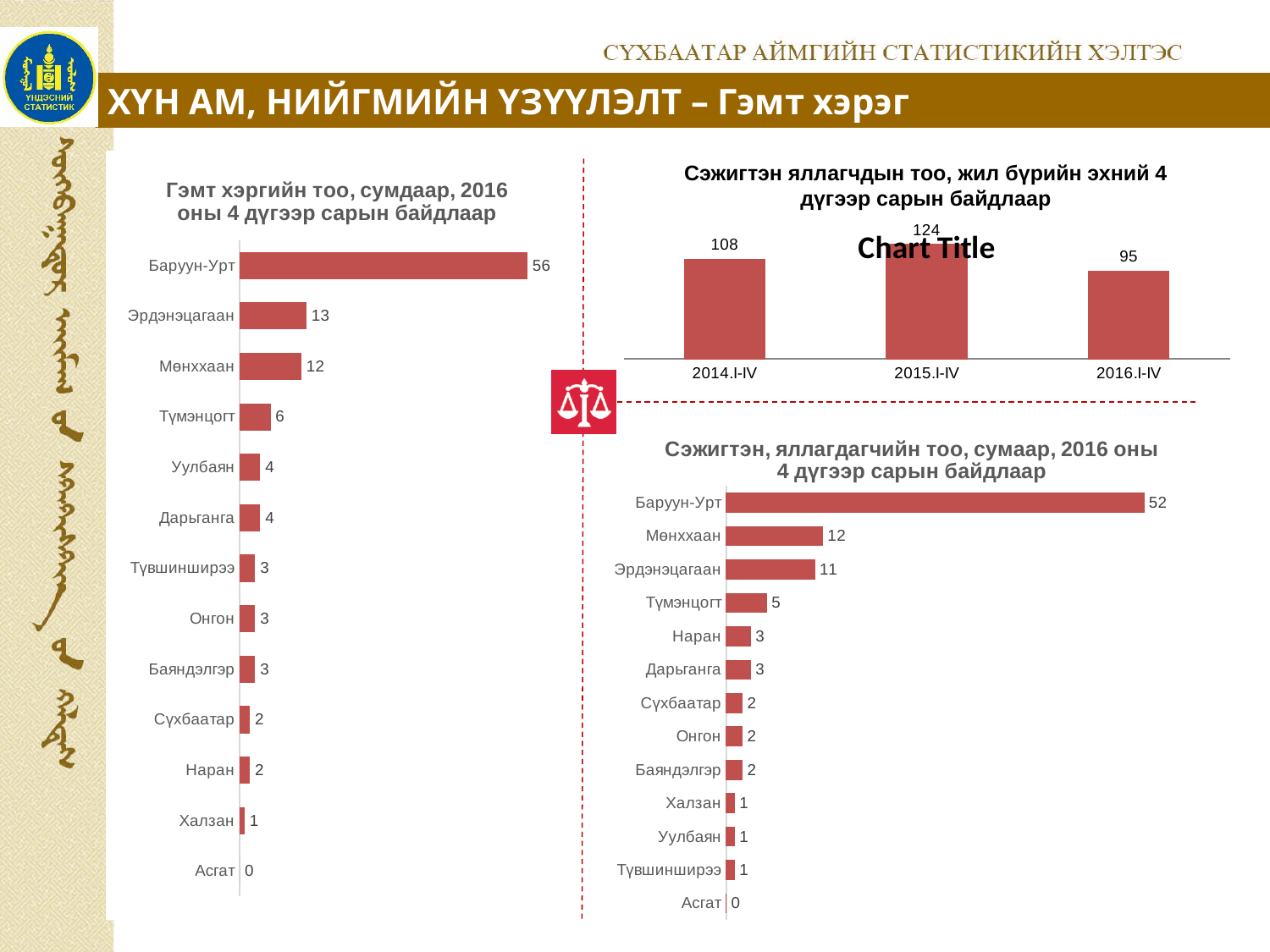
In the left chart (Гэмт хэргийн тоо, сумдаар), how many categories are shown? 13 What kind of chart is the top right chart (Сэжигтэн яллагчдын тоо)? bar chart In the left chart (Гэмт хэргийн тоо, сумдаар), what is the value for Баруун-Урт? 56 In the top right chart (Сэжигтэн яллагчдын тоо), what is the difference between 2015.I-IV and 2016.I-IV? 29 In the top right chart (Сэжигтэн яллагчдын тоо), what is the value for 2015.I-IV? 124 In the left chart (Гэмт хэргийн тоо, сумдаар), which category has the lowest value? Асгат In the bottom right chart (Сэжигтэн, яллагдагчийн тоо, сумаар), which is larger, Мөнххаан or Эрдэнэцагаан? Мөнххаан In the top right chart (Сэжигтэн яллагчдын тоо), which period has the lowest value? 2016.I-IV In the left chart (Гэмт хэргийн тоо, сумдаар), which category has the highest value? Баруун-Урт In the bottom right chart (Сэжигтэн, яллагдагчийн тоо, сумаар), what is the value for Түмэнцогт? 5 In the bottom right chart (Сэжигтэн, яллагдагчийн тоо, сумаар), how many categories are shown? 13 In the left chart (Гэмт хэргийн тоо, сумдаар), what is the difference between Эрдэнэцагаан and Мөнххаан? 1